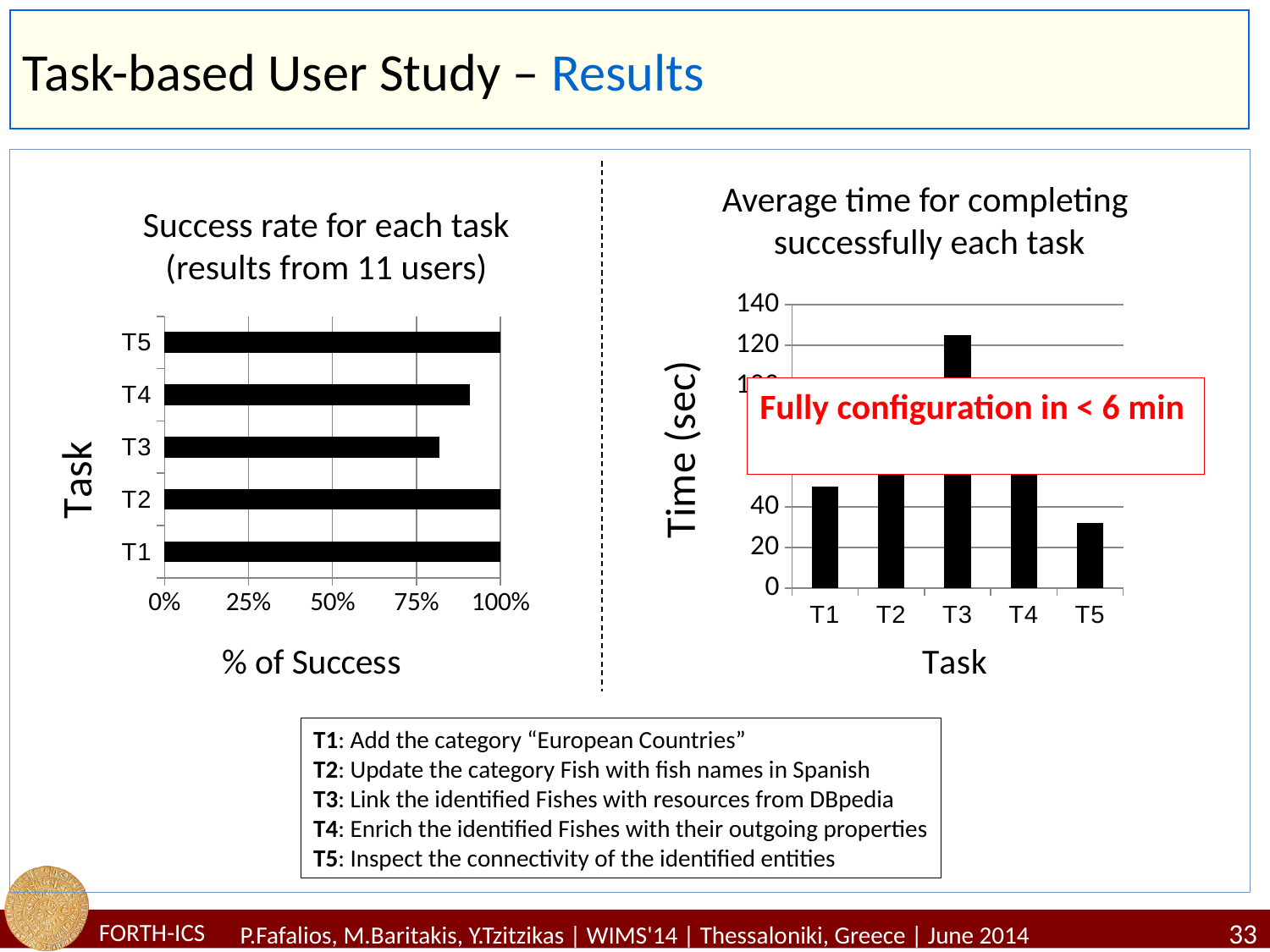
In the 'Success rate for each task' chart on the left, what is the success rate for T1? 100% In the 'Success rate for each task' chart on the left, what is the success rate for T5? 100% What is the y-axis label of the 'Average time for completing successfully each task' chart on the right? Time (sec) In the 'Success rate for each task' chart on the left, which task has the lowest success rate? T3 How many tasks are shown in the 'Success rate for each task' chart on the left? 5 In the 'Success rate for each task' chart on the left, is the success rate for T4 greater or less than 100%? less In the 'Average time for completing successfully each task' chart on the right, is the value for T5 greater or less than 40? less What kind of chart is the 'Success rate for each task' chart on the left? bar chart In the 'Success rate for each task' chart on the left, is the success rate for T3 greater or less than 75%? greater In the 'Average time for completing successfully each task' chart on the right, which task has the lowest average time? T5 What kind of chart is the 'Average time for completing successfully each task' chart on the right? bar chart In the 'Average time for completing successfully each task' chart on the right, which task has the highest average time? T3